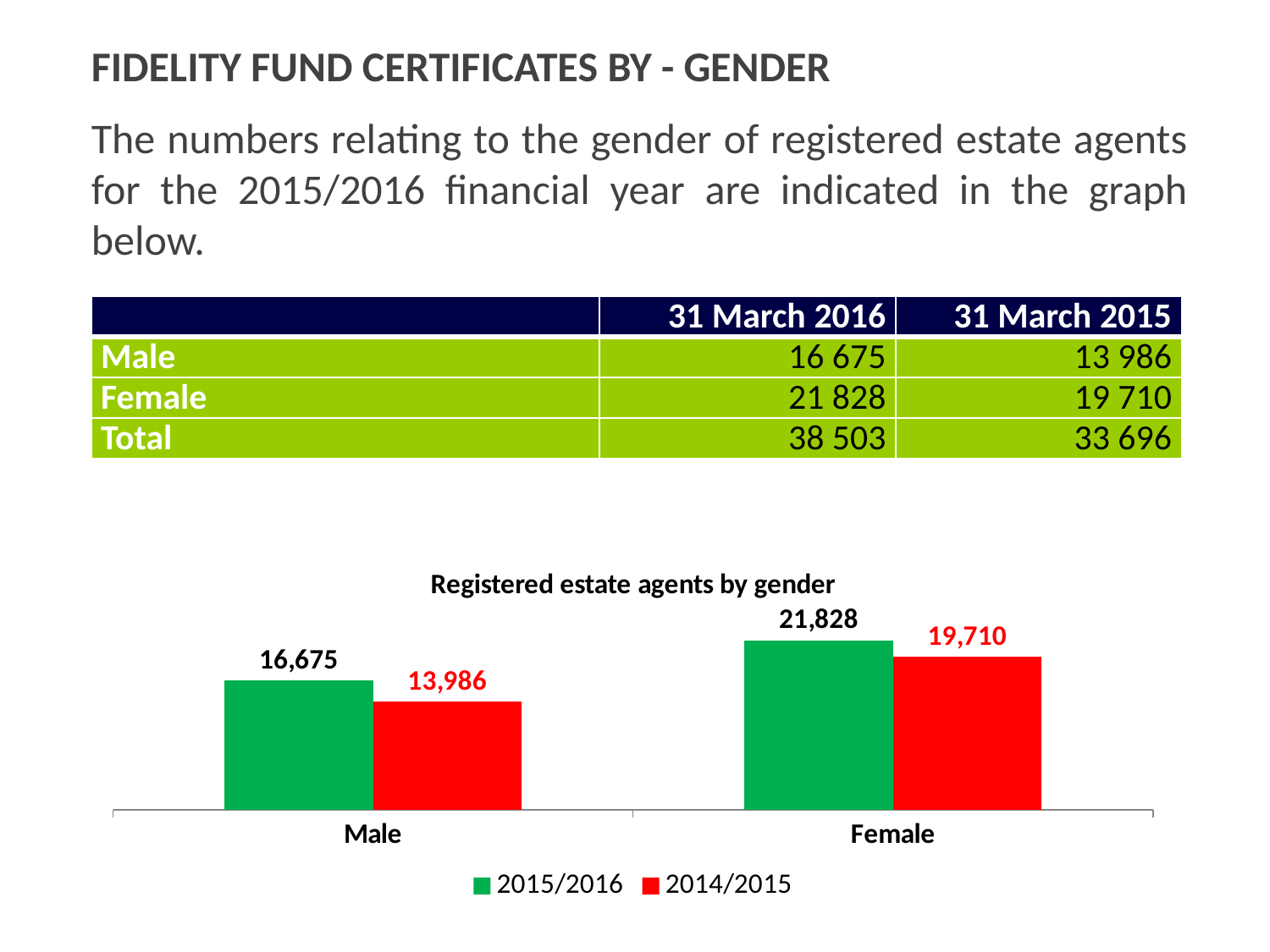
How many series does the chart legend list? 2 What is the difference between the 2015/2016 and 2014/2015 values for Male? 2,689 What type of chart is shown on the slide? Bar chart What is the value for Female in the 2015/2016 series? 21,828 Which category has the highest value in the 2015/2016 series? Female Which category has the lowest value in the 2014/2015 series? Male How many categories are shown on the x axis of the chart? 2 What is the value for Male in the 2014/2015 series? 13,986 Which is larger for Female: the 2015/2016 value or the 2014/2015 value? 2015/2016 What is the difference between the Female and Male values in the 2015/2016 series? 5,153 What is the value for Female in the 2014/2015 series? 19,710 What is the value for Male in the 2015/2016 series? 16,675